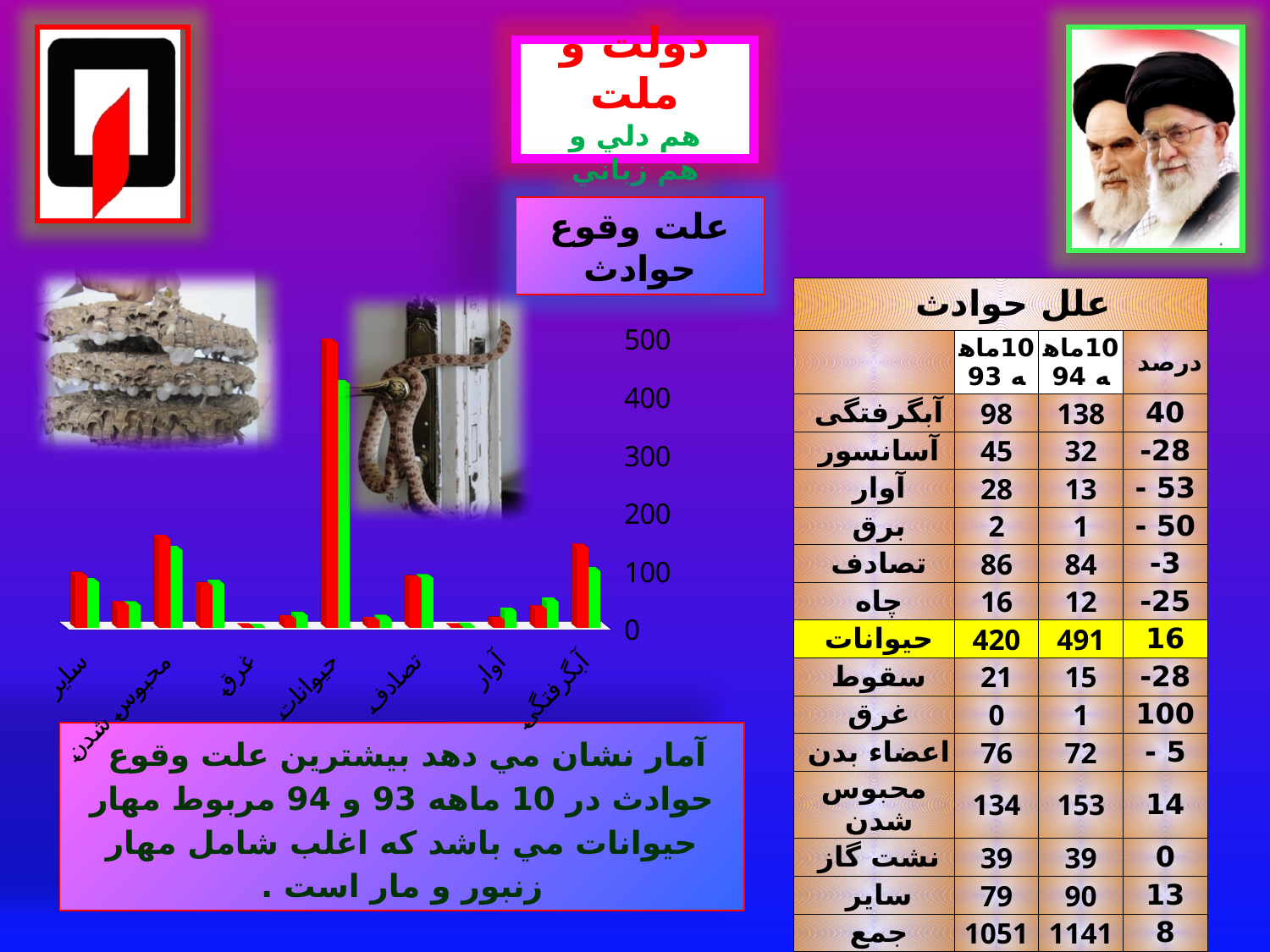
Which category has larger bars, محبوس شدن or آوار? محبوس شدن Which category has the tallest bars in the chart? حیوانات Is the value of the red bar for حیوانات greater or less than 400? greater Is the value of the green bar for حیوانات greater or less than 400? greater What is the highest value shown on the chart's vertical axis? 500 Which category has larger bars, حیوانات or تصادف? حیوانات What kind of chart is shown on the left of the slide? bar chart Is the value of the green bar for محبوس شدن greater or less than 100? greater What two colours are used for the bars in the chart? red and green